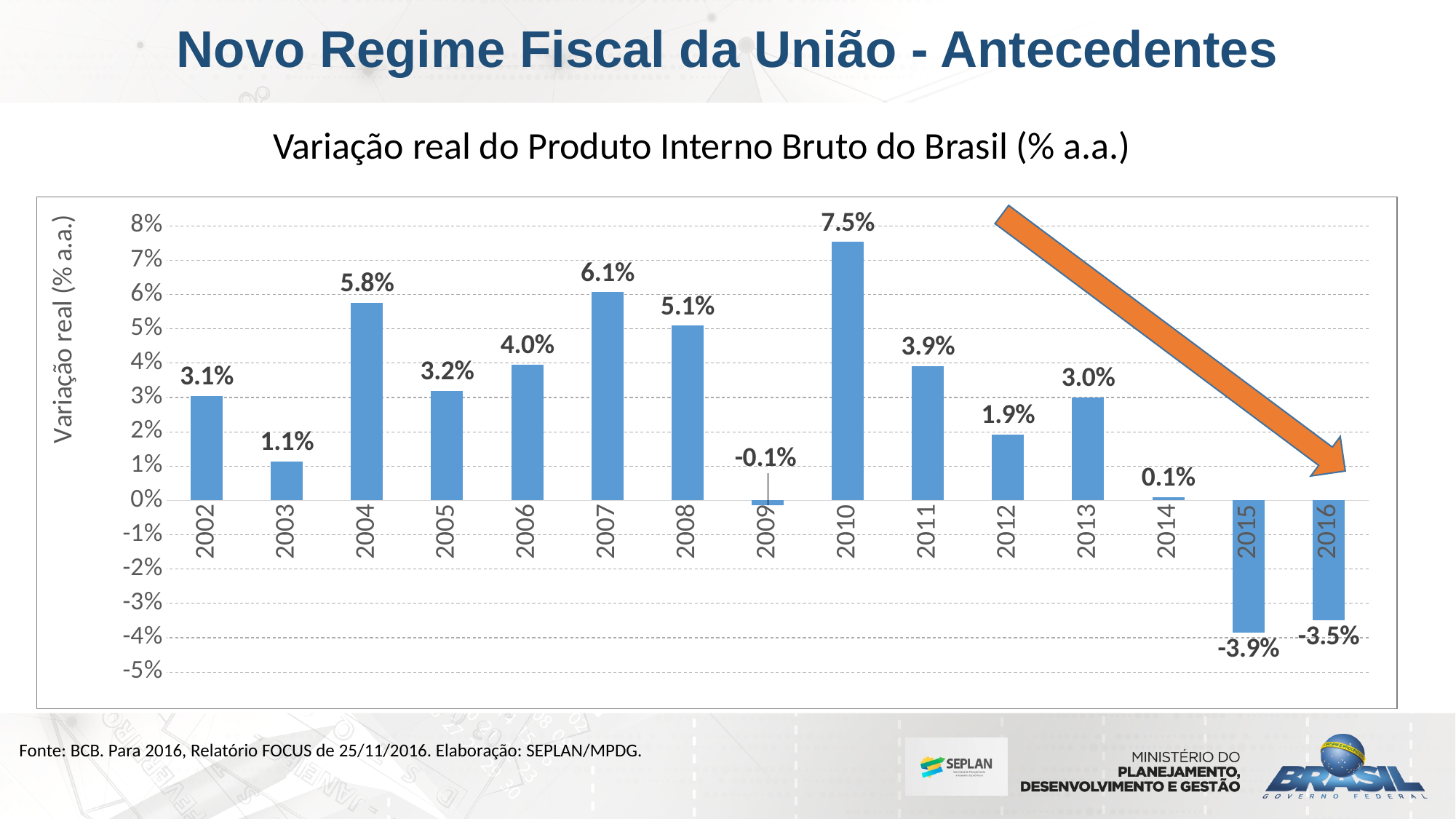
Do the values rise or fall from 2013 to 2016? fall What is the value for 2009? -0.1% What is the title of the chart? Variação real do Produto Interno Bruto do Brasil (% a.a.) Which is larger, the value for 2004 or the value for 2011? 2004 How many years are shown on the x axis? 15 Is the value for 2016 greater or less than -3%? less What kind of chart is this? bar chart Which year has the lowest value? 2015 What is the value for 2010? 7.5% Which year has the highest value? 2010 What is the difference between the values for 2007 and 2008? 1.0% What is the value for 2015? -3.9%